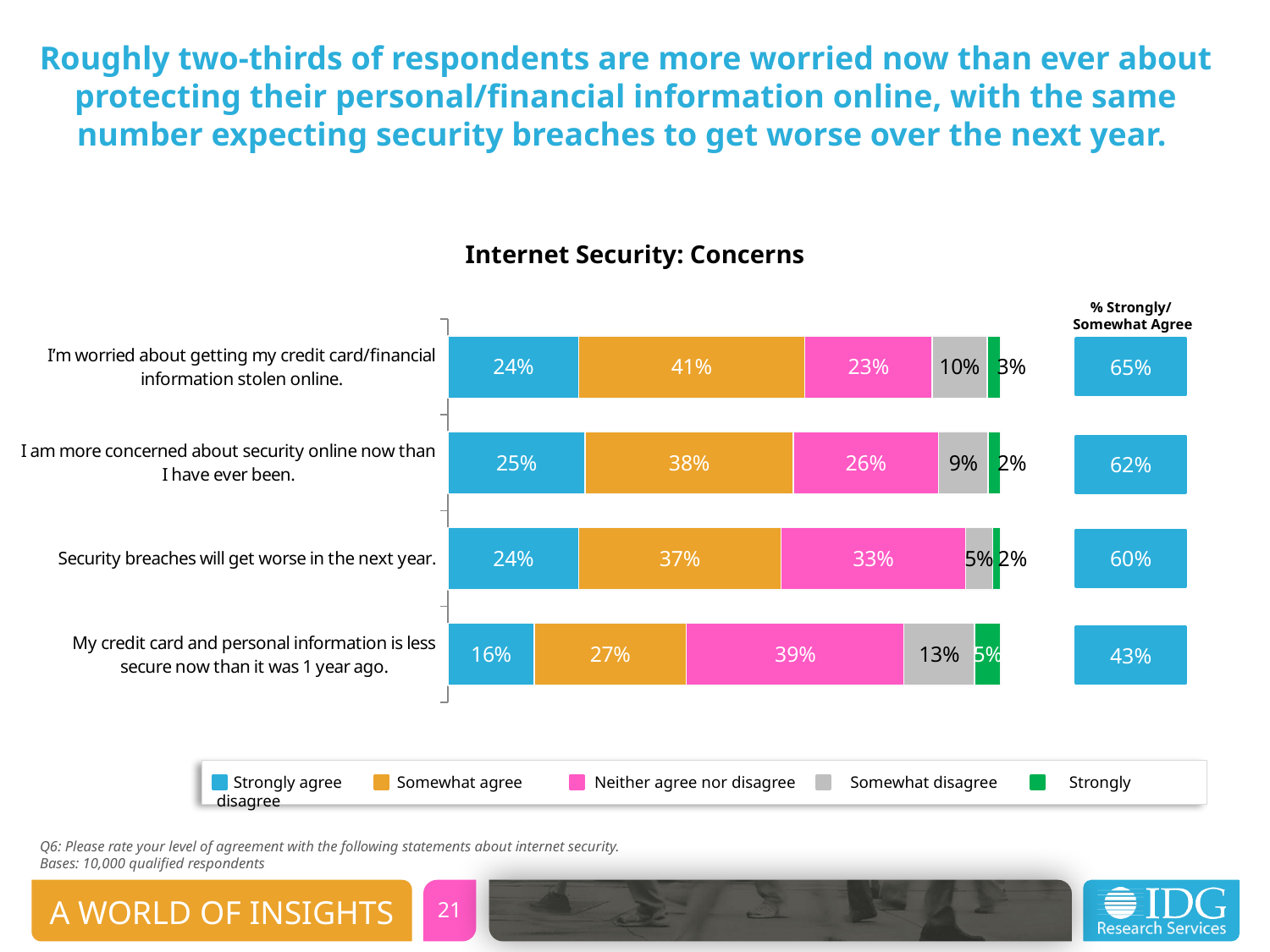
Which statement has the lowest Strongly agree percentage? My credit card and personal information is less secure now than it was 1 year ago. What is the % Strongly/Somewhat Agree figure for "I am more concerned about security online now than I have ever been"? 62% Which statement has the highest % Strongly/Somewhat Agree? I'm worried about getting my credit card/financial information stolen online. What percentage of respondents strongly agree that security breaches will get worse in the next year? 24% How many response categories does the legend list? 5 How many statements are shown in the chart? 4 Which statement has a larger Neither agree nor disagree share: "Security breaches will get worse in the next year" or "I am more concerned about security online now than I have ever been"? Security breaches will get worse in the next year. What is the combined Somewhat disagree and Strongly disagree share for "I'm worried about getting my credit card/financial information stolen online"? 13% How many percentage points higher is the Somewhat agree share for "I'm worried about getting my credit card/financial information stolen online" than for "My credit card and personal information is less secure now than it was 1 year ago"? 14 percentage points What kind of chart is shown on the slide? Stacked bar chart What percentage neither agree nor disagree that their credit card and personal information is less secure now than it was 1 year ago? 39% What percentage somewhat agree with the statement "I'm worried about getting my credit card/financial information stolen online"? 41%